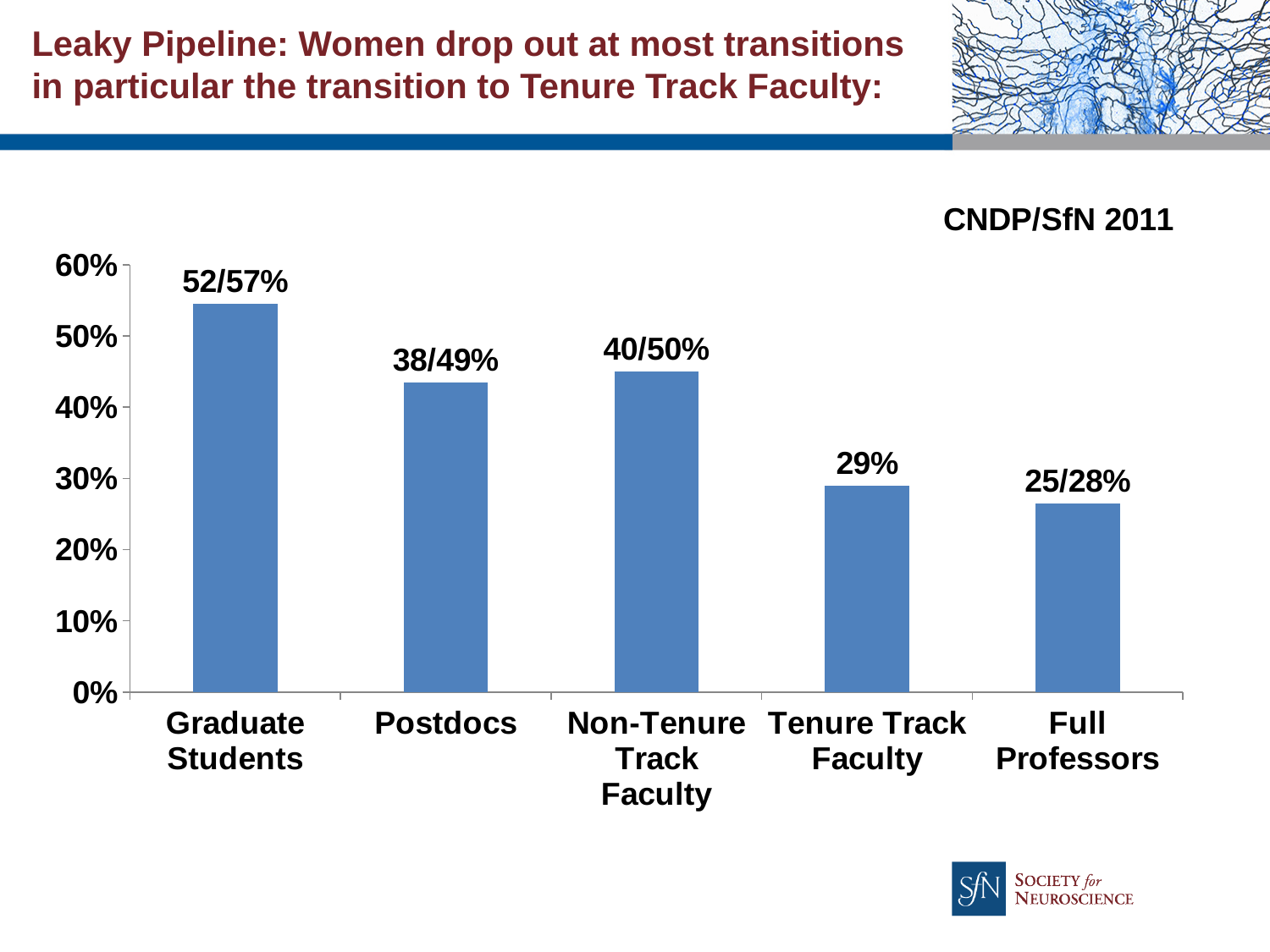
What is the data label shown for Tenure Track Faculty? 29% What is the data label shown for Full Professors? 25/28% What is the data label shown for Non-Tenure Track Faculty? 40/50% Is the value for Tenure Track Faculty greater or less than 40%? less How many categories are shown on the x axis? 5 What is the data label shown for Postdocs? 38/49% What is the title printed above the chart? CNDP/SfN 2011 What is the data label shown for Graduate Students? 52/57% Is the bar for Graduate Students taller than the bar for Postdocs? Yes Which category has the shortest bar? Full Professors Which category has the tallest bar? Graduate Students What kind of chart is shown on the slide? Bar chart